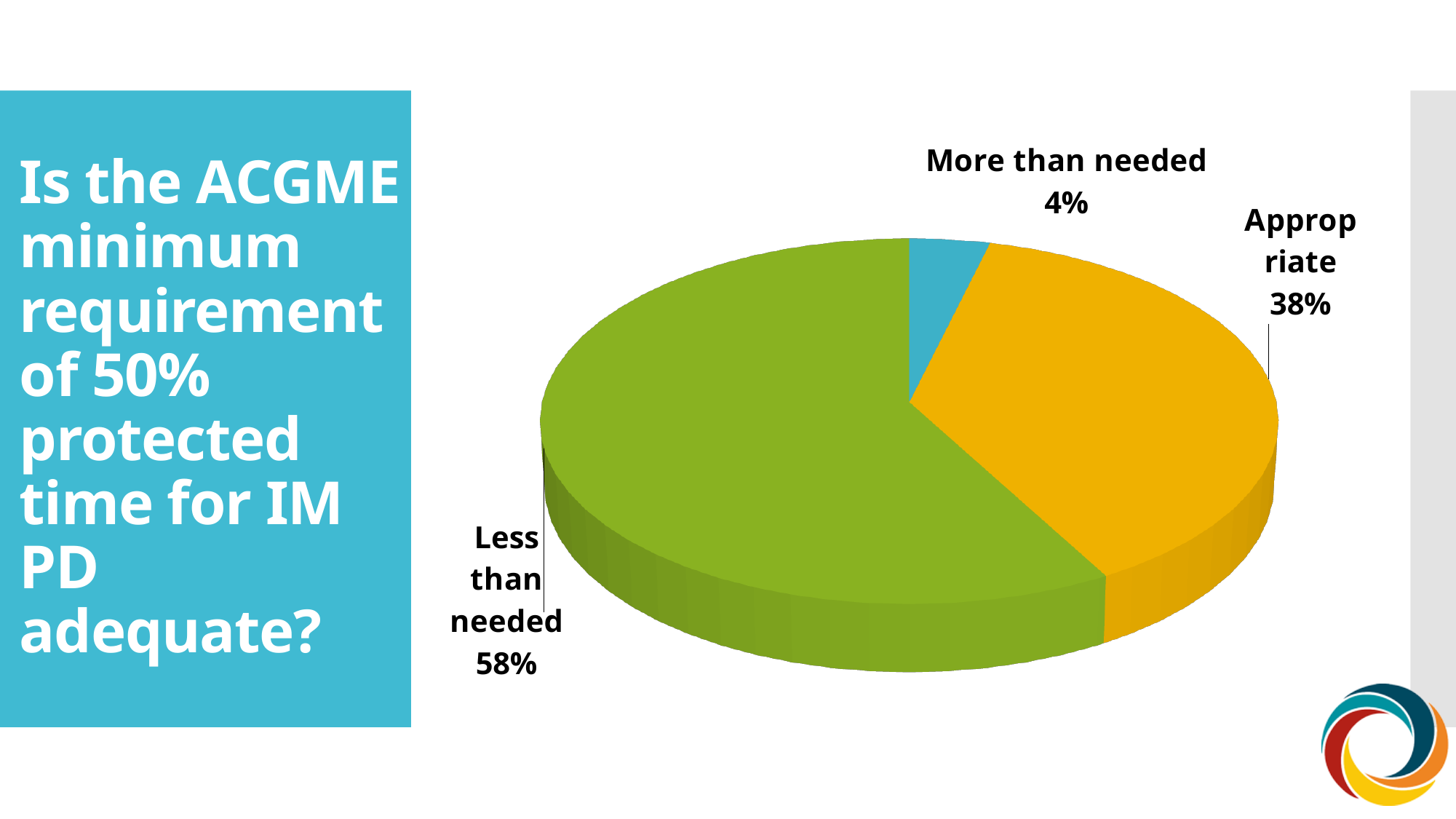
What kind of chart is shown on the slide? Pie chart Which slice of the pie is the largest? Less than needed What colour is the "Less than needed" slice? Green What question does the text on the left of the slide ask? Is the ACGME minimum requirement of 50% protected time for IM PD adequate? What is the difference in percentage points between the "Less than needed" and "Appropriate" slices? 20 What share of the pie is labelled "Less than needed"? 58% How many slices does the pie chart have? 3 What is the difference in percentage points between the "Appropriate" and "More than needed" slices? 34 Which is larger, the "Appropriate" slice or the "More than needed" slice? Appropriate Which slice of the pie is the smallest? More than needed What share of the pie is labelled "More than needed"? 4% What share of the pie is labelled "Appropriate"? 38%